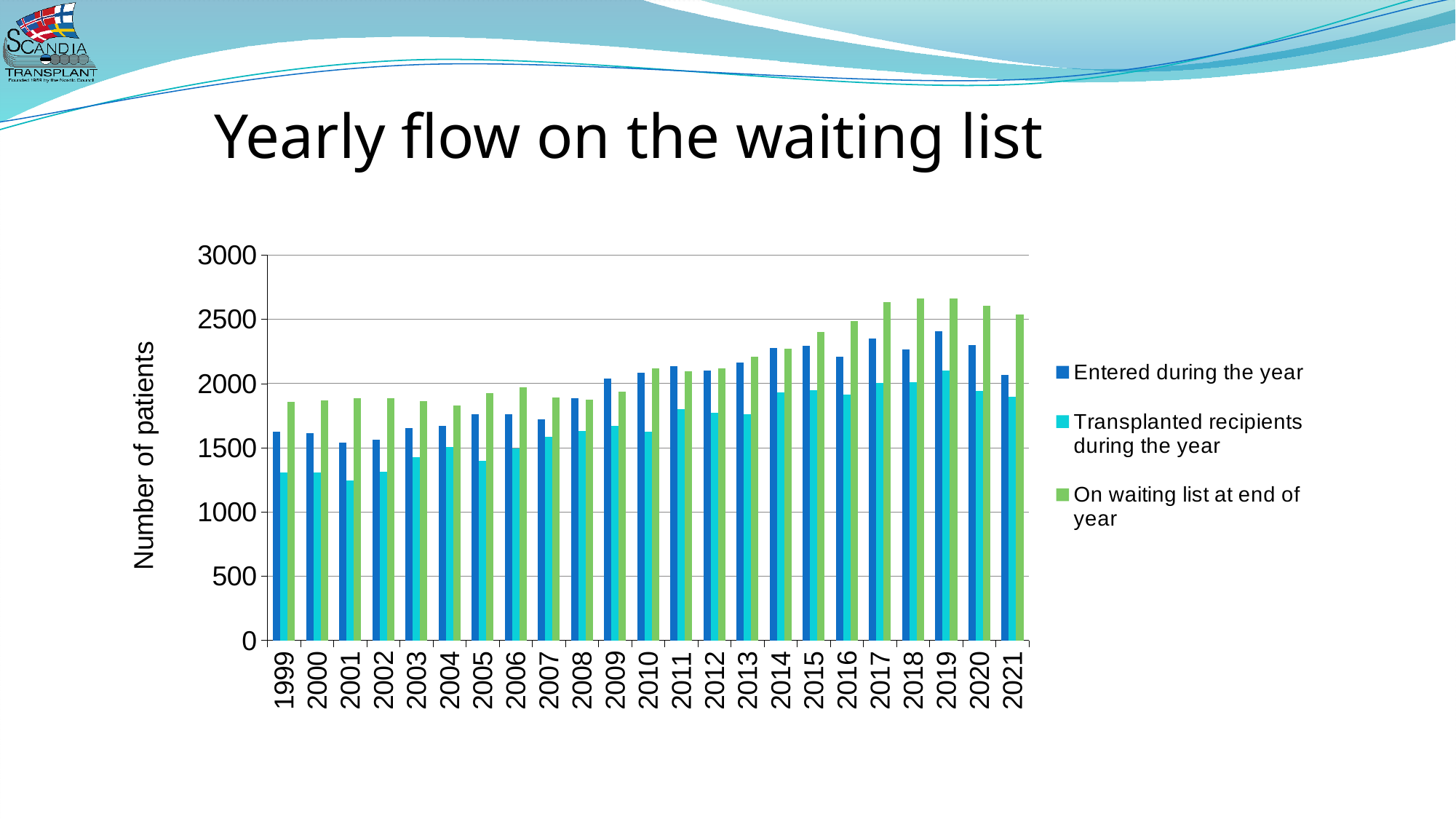
Which year has the highest value for 'Entered during the year'? 2019 How many years are shown on the x axis? 23 What is the label of the y axis? Number of patients Which year has the lowest value for 'Transplanted recipients during the year'? 2001 What kind of chart is shown on the slide? Bar chart Is the value for 'Entered during the year' in 2019 greater or less than 2000? greater In 2019, which is larger: 'Entered during the year' or 'Transplanted recipients during the year'? Entered during the year Which year has the highest value for 'Transplanted recipients during the year'? 2019 Is the value for 'Transplanted recipients during the year' in 1999 greater or less than 1500? less How many series does the legend list? 3 Does the 'On waiting list at end of year' series generally rise or fall from 1999 to 2019? rise Is the value for 'On waiting list at end of year' in 2018 greater or less than 2500? greater